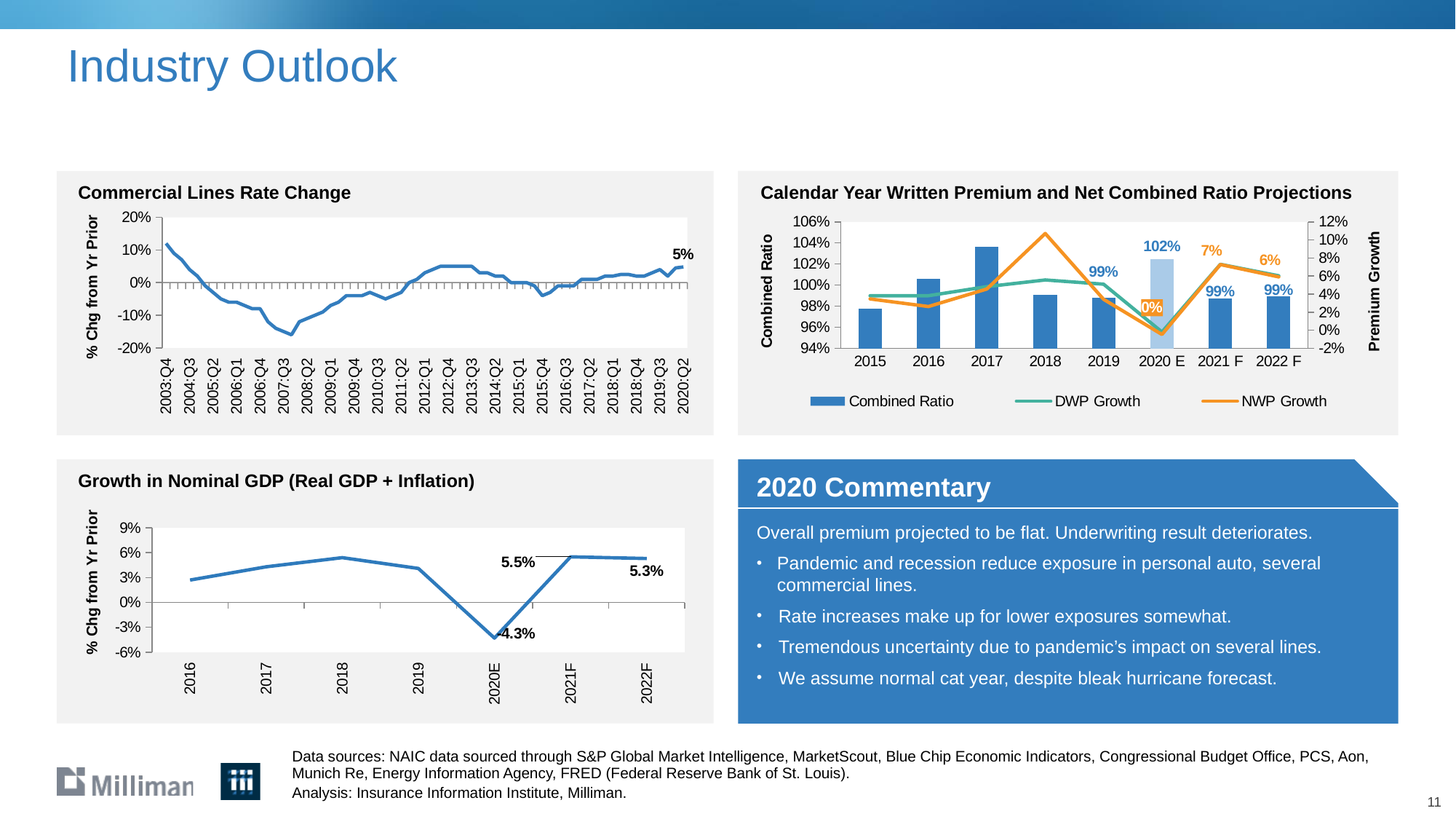
How many series does the legend of the Calendar Year Written Premium and Net Combined Ratio Projections chart list? 3 In the Growth in Nominal GDP chart, what is the value for 2020E? -4.3% In the Calendar Year Written Premium and Net Combined Ratio Projections chart, what is the NWP Growth value for 2021 F? 7% In the Calendar Year Written Premium and Net Combined Ratio Projections chart, which year has the lowest combined ratio bar? 2015 In the Calendar Year Written Premium and Net Combined Ratio Projections chart, how many years are shown on the x axis? 8 In the Calendar Year Written Premium and Net Combined Ratio Projections chart, what is the combined ratio for 2020 E? 102% In the Commercial Lines Rate Change chart, is the value for 2007:Q3 greater or less than -10%? less In the Growth in Nominal GDP chart, which year has the lowest value? 2020E In the Commercial Lines Rate Change chart, what is the labeled value for 2020:Q2? 5% In the Growth in Nominal GDP chart, what is the difference between the 2021F and 2022F values? 0.2% What kind of chart is the Commercial Lines Rate Change chart? line chart